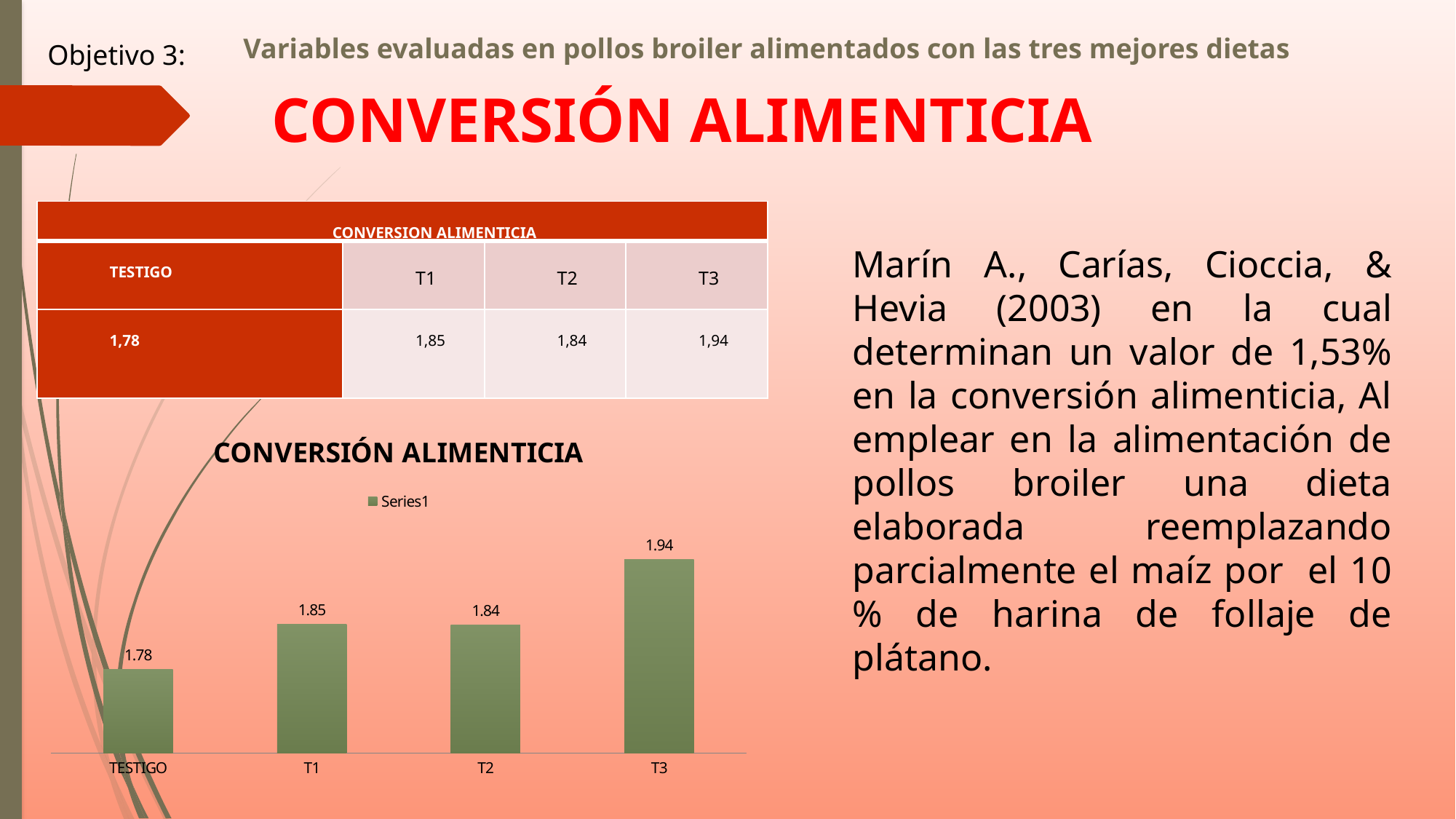
What type of chart is shown on the slide? bar chart How many categories are shown on the x axis of the chart? 4 What is the value for T1 in the chart? 1.85 What is the value for T3 in the chart? 1.94 What is the value for T2 in the chart? 1.84 Which category has the lowest value in the chart? TESTIGO What is the difference between the values for T1 and T2? 0.01 What is the value for TESTIGO in the chart? 1.78 What is the title of the chart? CONVERSIÓN ALIMENTICIA What is the difference between the values for T3 and TESTIGO? 0.16 Which is larger, the value for T3 or the value for T1? T3 Which category has the highest value in the chart? T3